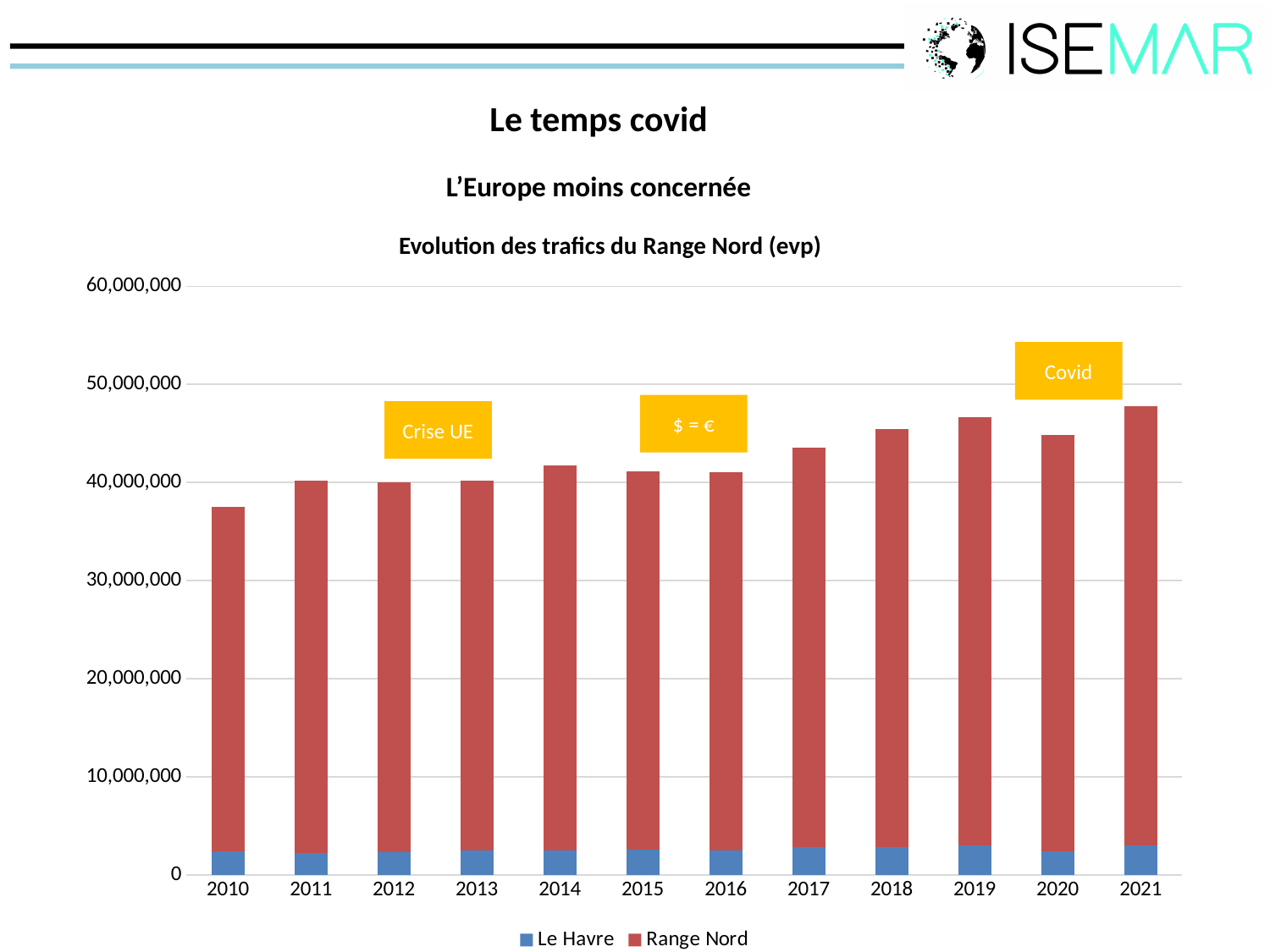
Is the total value for 2010 greater or less than 40,000,000? less What kind of chart is shown on the slide? Stacked bar chart Overall, do the total bars rise or fall from 2010 to 2021? rise What is the title of the chart? Evolution des trafics du Range Nord (evp) Is the total value for 2021 greater or less than 50,000,000? less Which year has the lowest total bar in the chart? 2010 Is the Le Havre value for 2021 greater or less than 10,000,000? less Which year has the highest total bar in the chart? 2021 Which year has the larger total bar, 2019 or 2020? 2019 How many years are shown on the x axis of the chart? 12 How many series does the chart legend list? 2